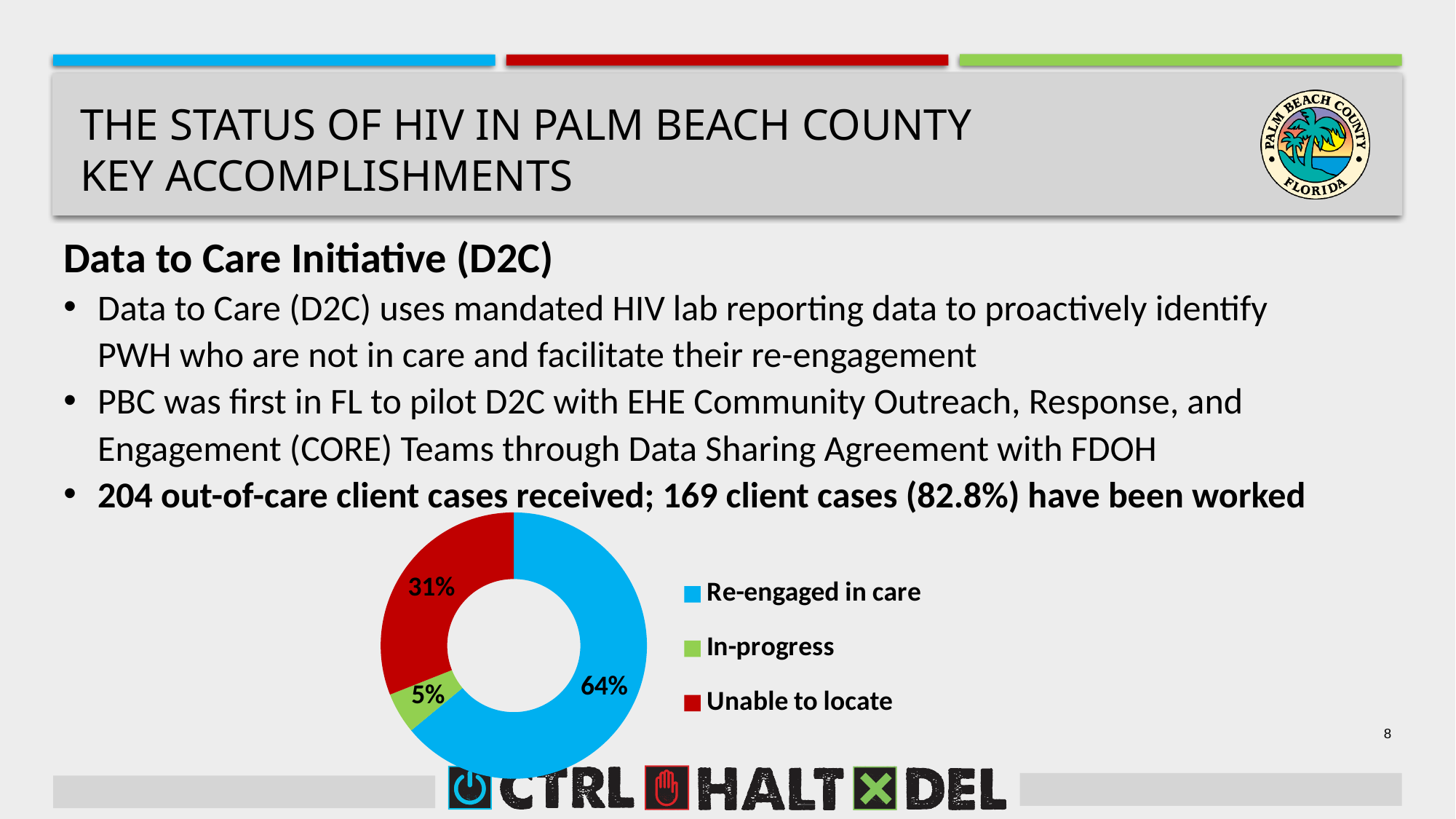
What colour represents In-progress in the chart? Green What percentage of the donut chart is labelled In-progress? 5% Which category has the largest share of the donut chart? Re-engaged in care Which category has the smallest share of the donut chart? In-progress What percentage of the donut chart is labelled Re-engaged in care? 64% How many categories does the donut chart show? 3 What is the difference in percentage points between Re-engaged in care and Unable to locate? 33 What percentage of the donut chart is labelled Unable to locate? 31% What is the combined share of Re-engaged in care and In-progress? 69% What kind of chart is shown on the slide? Donut (pie) chart Which is larger in the donut chart, Unable to locate or In-progress? Unable to locate What colour represents Unable to locate in the chart? Red